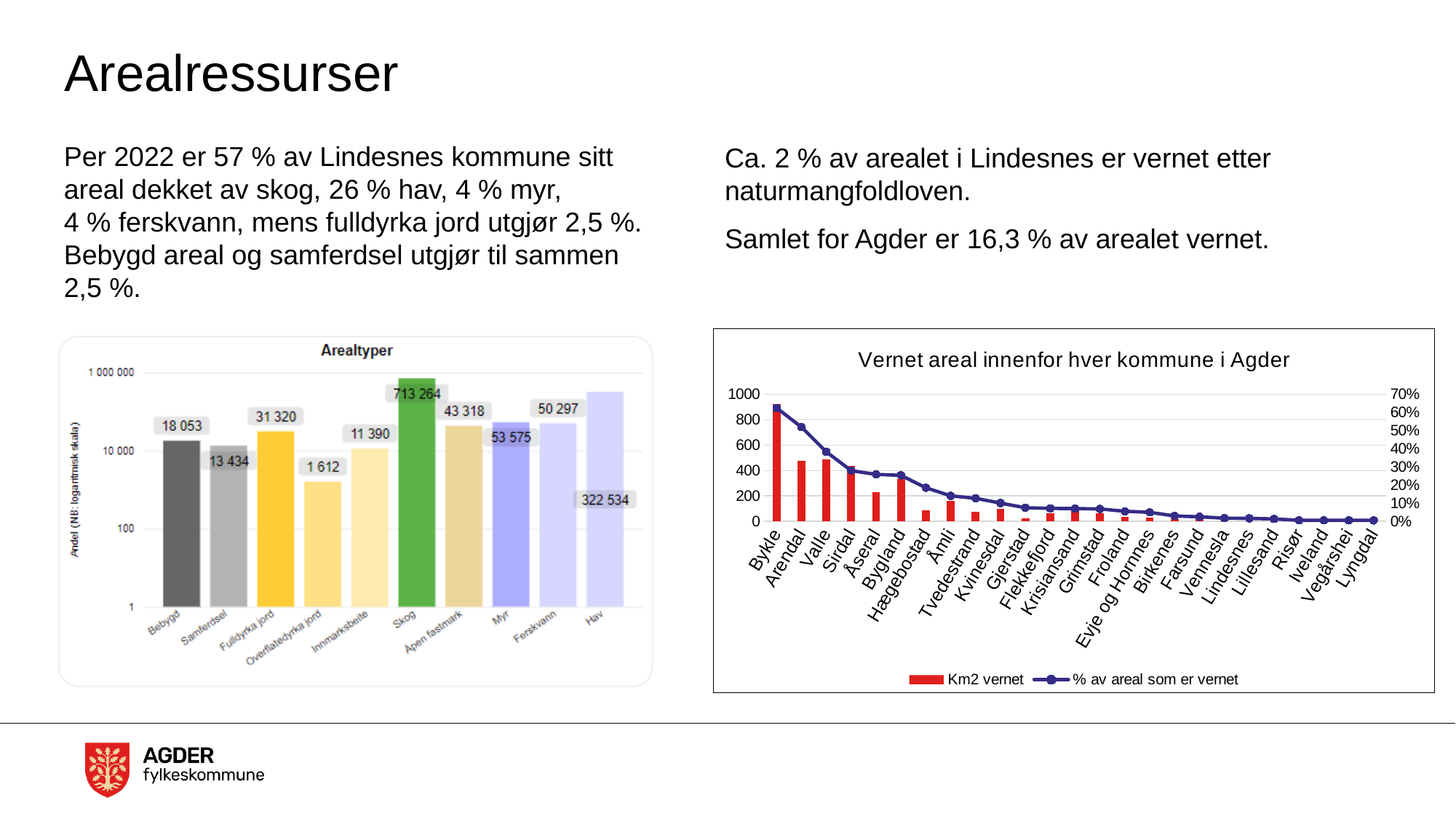
In the Arealtyper chart, what is the value for Overflatedyrka jord? 1 612 In the Arealtyper chart, which category has the highest value? Skog How many series does the legend list in the chart titled 'Vernet areal innenfor hver kommune i Agder'? 2 In the Arealtyper chart, what is the value for Skog? 713 264 In the Arealtyper chart, which category has the lowest value? Overflatedyrka jord In the chart titled 'Vernet areal innenfor hver kommune i Agder', is the Km2 vernet value for Arendal greater or less than 600? less How many categories are shown in the Arealtyper chart? 10 In the Arealtyper chart, what is the value for Hav? 322 534 In the chart titled 'Vernet areal innenfor hver kommune i Agder', does the '% av areal som er vernet' line rise or fall from left to right? fall In the chart titled 'Vernet areal innenfor hver kommune i Agder', which municipality has the highest Km2 vernet? Bykle In the Arealtyper chart, which is larger, Myr or Ferskvann? Myr In the Arealtyper chart, what is the difference between the values for Bebygd and Samferdsel? 4 619